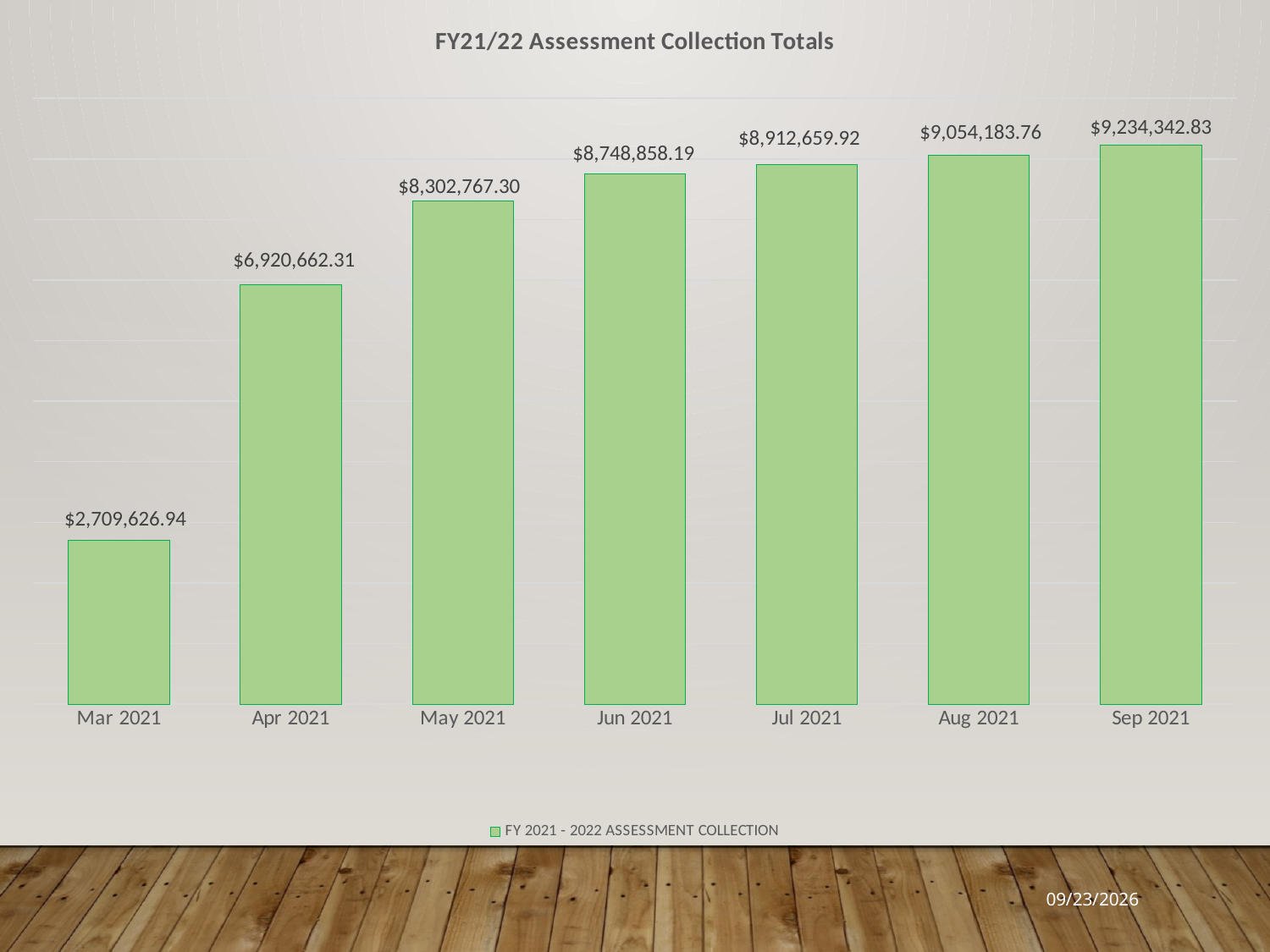
What kind of chart is shown on the slide? Bar chart Which month has the lowest collection total? Mar 2021 What is the value for Mar 2021? $2,709,626.94 What is the value for Jun 2021? $8,748,858.19 Which is larger, the value for Apr 2021 or the value for May 2021? May 2021 What is the difference between the values for Jun 2021 and May 2021? $446,090.89 Do the values rise or fall from Mar 2021 to Sep 2021? Rise What is the value for Aug 2021? $9,054,183.76 How many months are shown on the chart? 7 How many series does the legend list? 1 What is the difference between the values for Apr 2021 and Mar 2021? $4,211,035.37 Which month has the highest collection total? Sep 2021